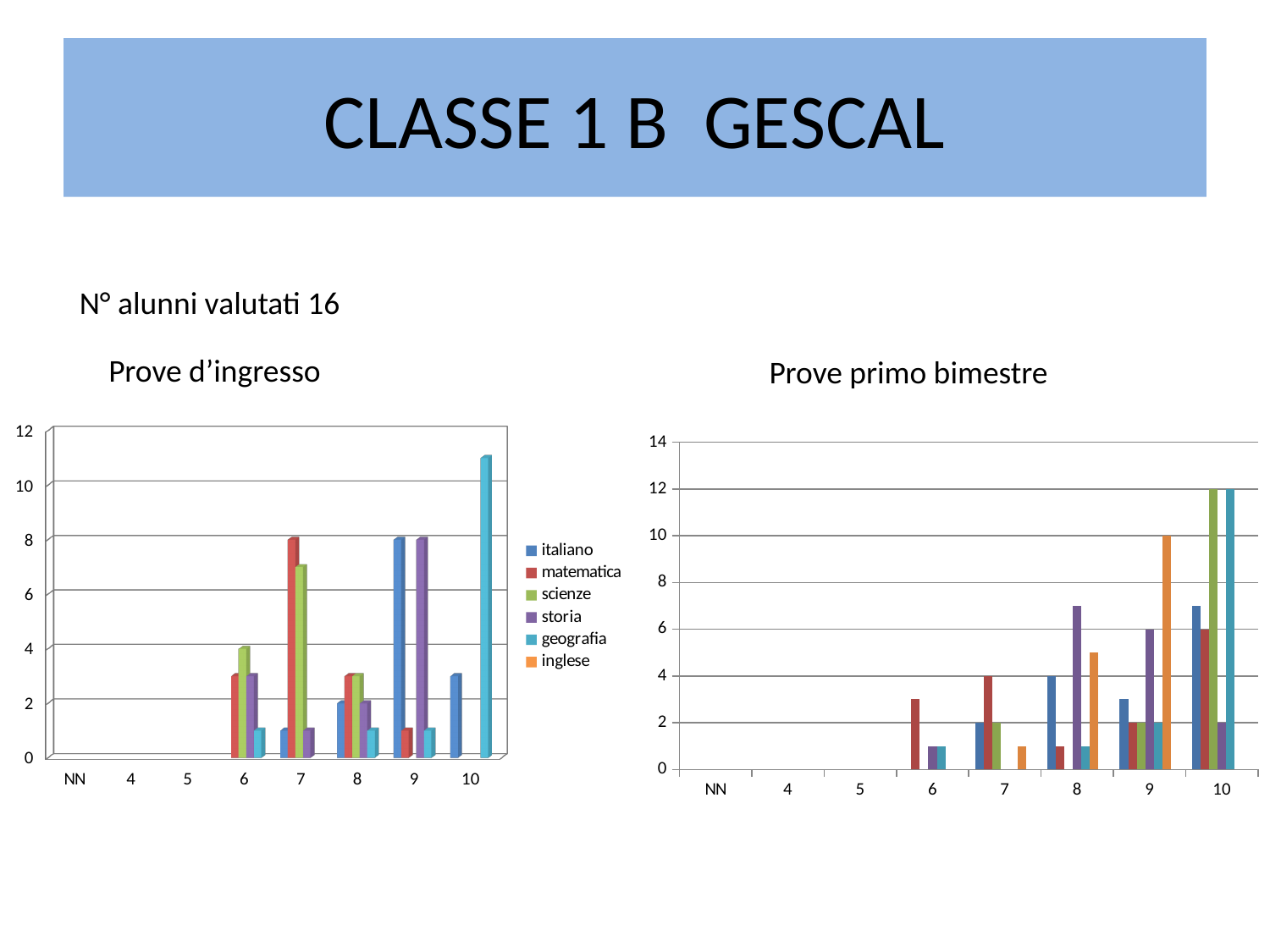
In the 'Prove primo bimestre' chart, which is larger: italiano at category 10 or storia at category 10? italiano What kind of chart is the 'Prove d'ingresso' chart? bar chart In the 'Prove primo bimestre' chart, is the value for storia at category 8 greater or less than 6? greater How many categories are shown on the x axis of the 'Prove primo bimestre' chart? 8 In the 'Prove primo bimestre' chart, what is the value for matematica at category 7? 4 In the 'Prove d'ingresso' chart, what is the value for italiano at category 9? 8 In the 'Prove d'ingresso' chart, is the value for geografia at category 10 greater or less than 10? greater In the 'Prove d'ingresso' chart, what is the value for scienze at category 6? 4 In the 'Prove primo bimestre' chart, what is the value for inglese at category 9? 10 How many series does the legend list? 6 In the 'Prove d'ingresso' chart, which series has the tallest bar overall? geografia What is the title of the chart on the right of the slide? Prove primo bimestre